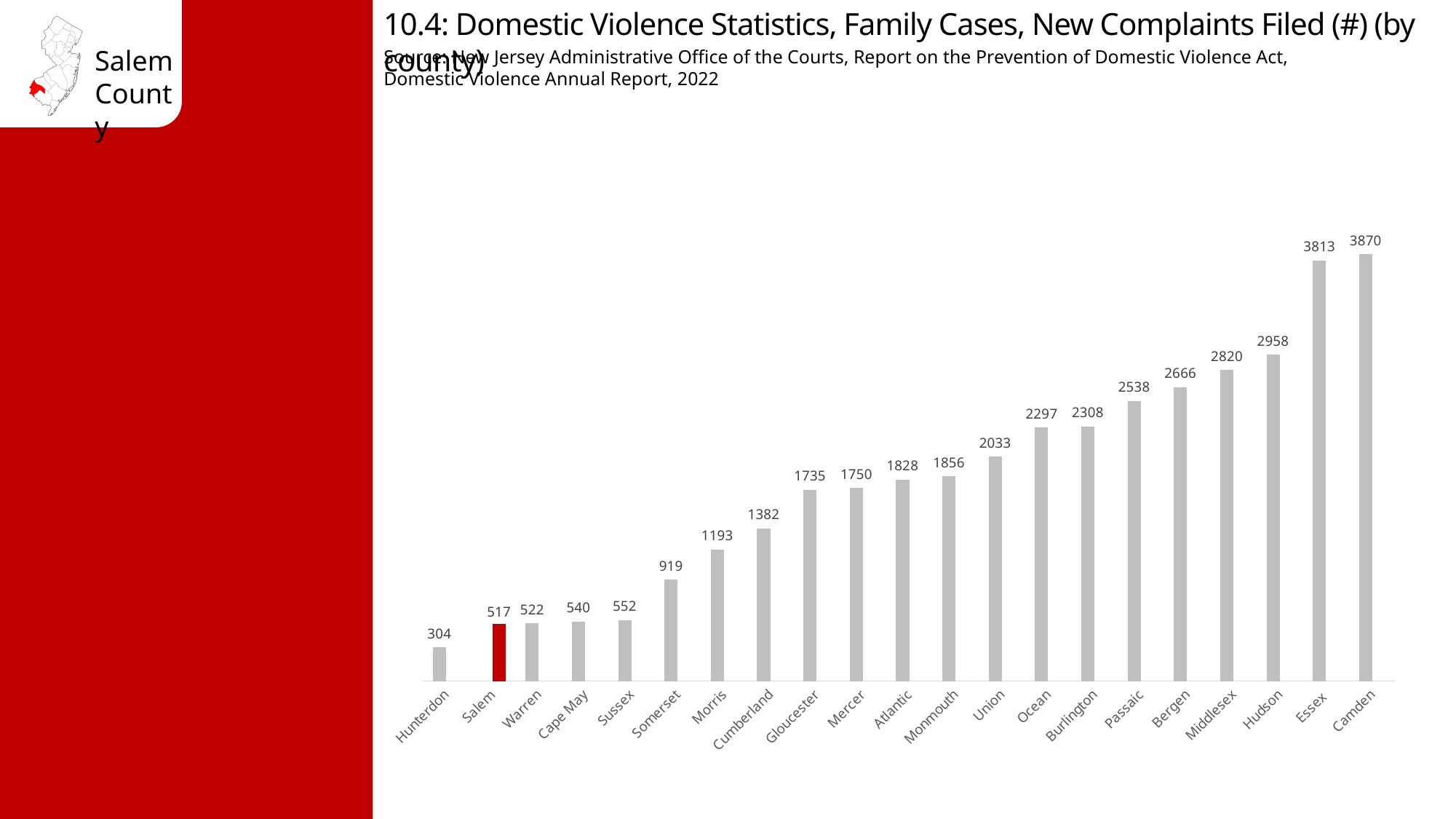
What is the difference between the values for Camden and Essex? 57 What is the number of new domestic violence family case complaints filed in Salem County? 517 Which county has the lowest number of new complaints filed? Hunterdon What is the value shown for Gloucester? 1735 How many counties are shown on the chart? 21 What is the difference between the values for Salem and Hunterdon? 213 Which county has the highest number of new complaints filed? Camden Which county's bar is highlighted in red? Salem What kind of chart is shown on the slide? Bar chart Which has a larger value, Hudson or Middlesex? Hudson What is the value shown for Camden? 3870 Which has a larger value, Cumberland or Morris? Cumberland